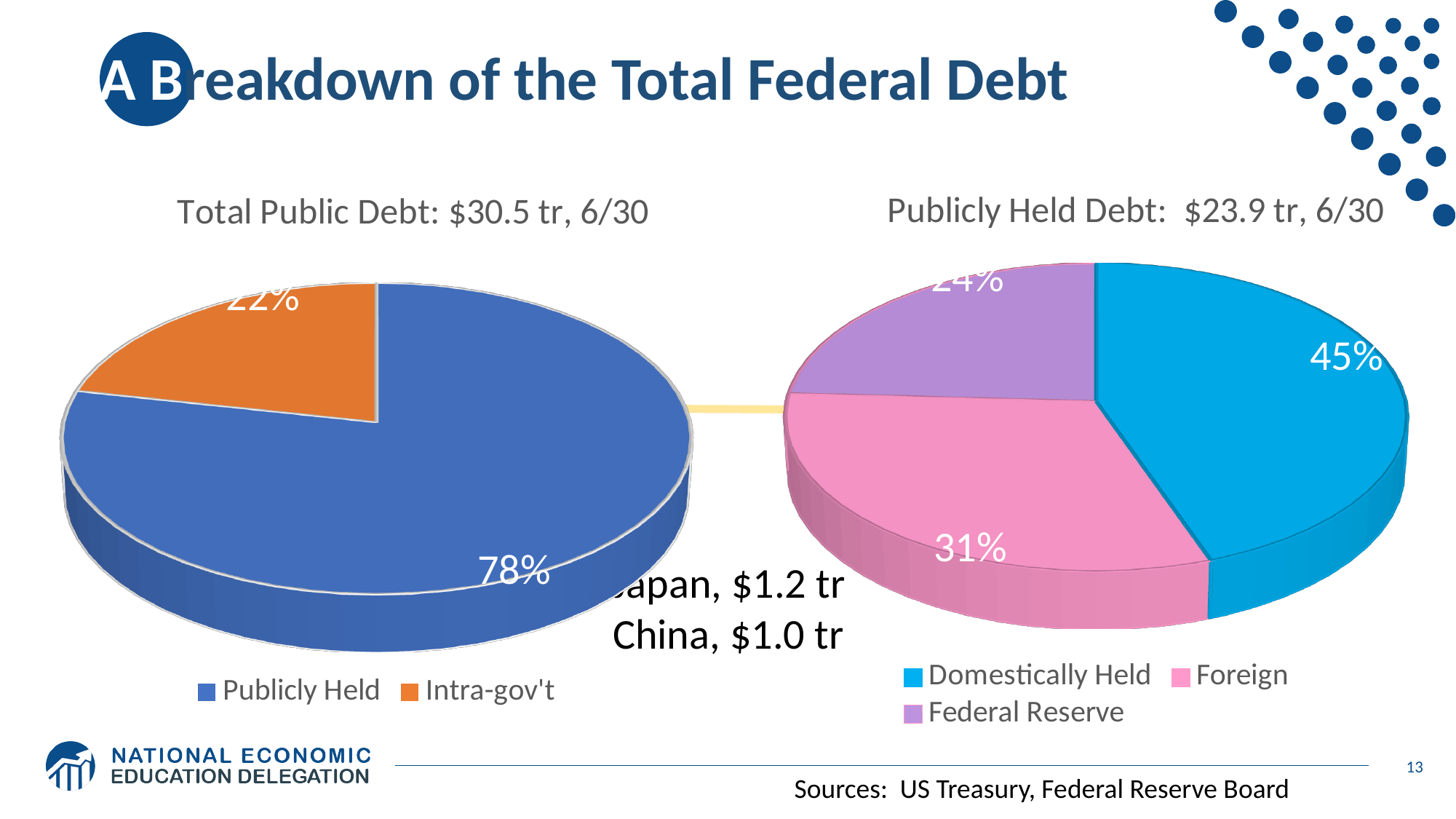
In the 'Publicly Held Debt' pie chart, what share is Federal Reserve? 24% In the 'Publicly Held Debt' pie chart, what is the difference in percentage points between Domestically Held and Foreign? 14 In the 'Total Public Debt' pie chart, what share is Intra-gov't? 22% In the 'Total Public Debt' pie chart, what share is Publicly Held? 78% What type of chart is the 'Total Public Debt' chart? Pie chart In the 'Publicly Held Debt' pie chart, which category has the smallest share? Federal Reserve How many entries does the legend of the 'Total Public Debt' chart list? 2 How many slices does the 'Publicly Held Debt' pie chart have? 3 In the 'Total Public Debt' pie chart, which is larger, Publicly Held or Intra-gov't? Publicly Held In the 'Publicly Held Debt' pie chart, which category has the largest share? Domestically Held